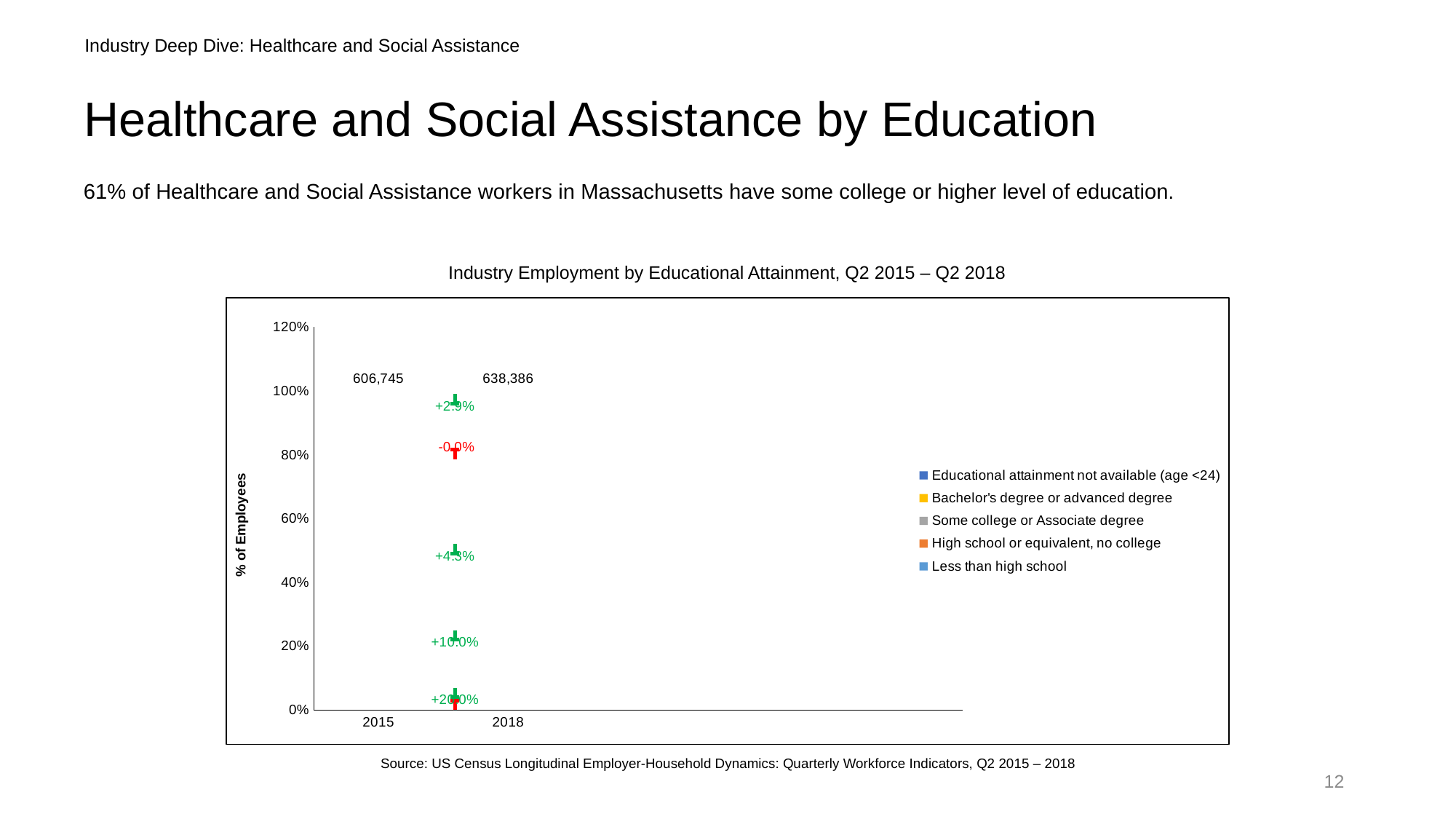
What is the label on the y axis of the chart? % of Employees What is the title of the chart? Industry Employment by Educational Attainment, Q2 2015 – Q2 2018 What total employment figure is printed above the 2018 column in the chart? 638,386 Which year has the larger total employment figure printed on the chart, 2015 or 2018? 2018 What percentage change is printed in red near the 80% line of the chart? -0.0% How many series does the chart's legend list? 5 What is the highest value shown on the y axis of the chart? 120% How many time periods are shown on the x axis of the chart? 2 What percentage change is printed in green near the top of the chart, between the 2015 and 2018 columns? +2.9% What total employment figure is printed above the 2015 column in the chart? 606,745 What is the difference between the total employment figures printed for 2018 and 2015? 31,641